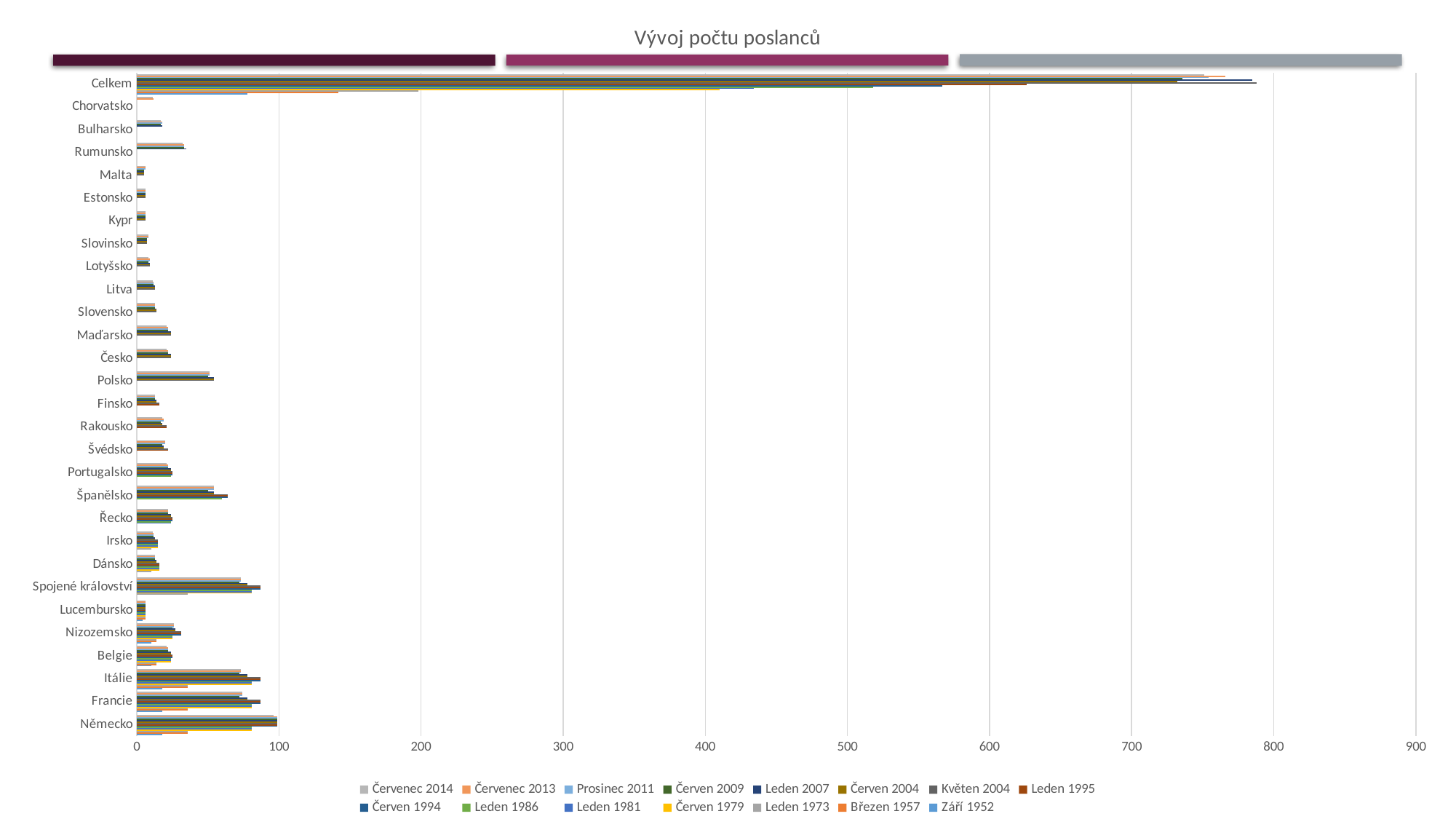
Which has the larger value in Červenec 2014, Německo or Spojené království? Německo Is the value for Spojené království in Červenec 2014 greater or less than 50? greater Is the value for Chorvatsko in Červenec 2014 greater or less than 100? less How many categories are shown on the vertical axis of the chart? 29 Which category has the highest values in the chart? Celkem Which has the larger value in Červenec 2014, Polsko or Česko? Polsko Is the value for Celkem in Leden 2007 greater or less than 700? greater What kind of chart is shown on the slide? bar chart Excluding Celkem, which country has the longest bars in the chart? Německo What is the title of the chart? Vývoj počtu poslanců How many series does the legend list? 15